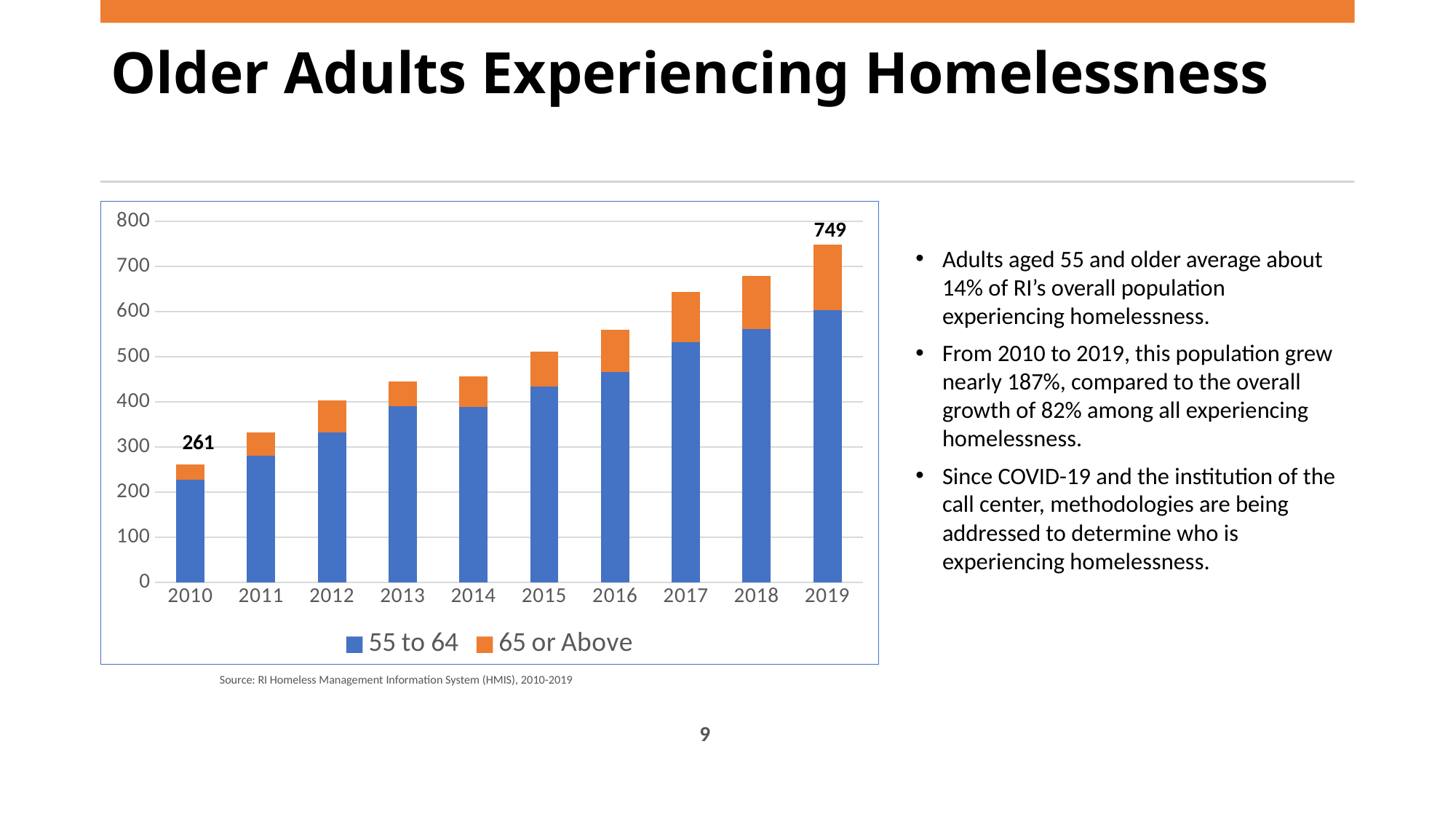
What kind of chart is shown on the slide? Stacked bar chart What is the difference between the 2019 total and the 2010 total? 488 Which year has the lowest total bar? 2010 What is the total value shown for 2019? 749 Is the total value for 2013 greater or less than 500? less Which year has a larger total, 2010 or 2019? 2019 How many series does the legend list? 2 What is the total value shown for 2010? 261 How many years are shown on the x axis? 10 Do the total values rise or fall from 2010 to 2019? Rise Which year has the highest total bar? 2019 Is the total value for 2017 greater or less than 600? greater